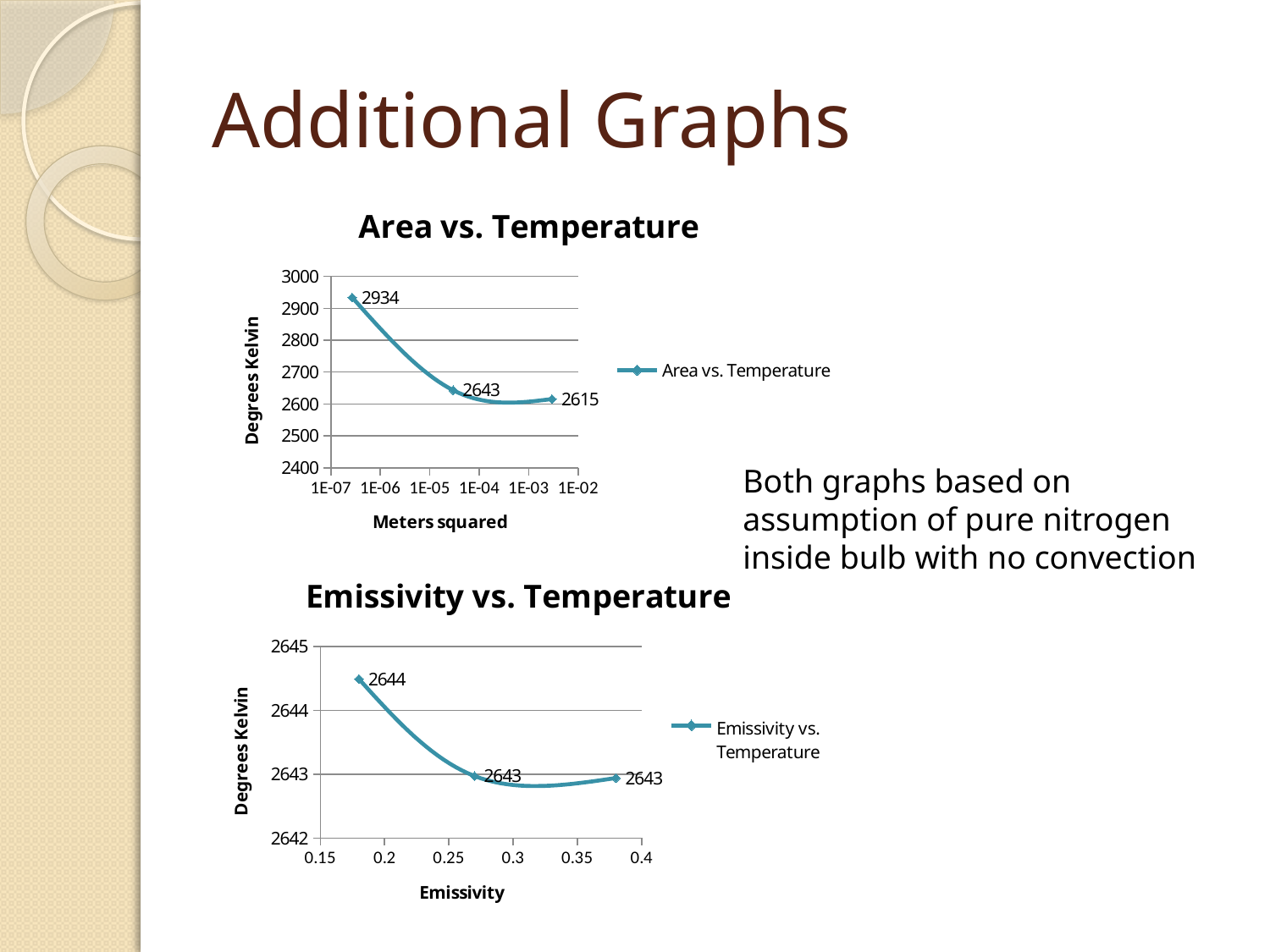
In the Emissivity vs. Temperature chart, what is the value of the last (rightmost) data point? 2643 In the Emissivity vs. Temperature chart, how many data points are plotted? 3 In the Emissivity vs. Temperature chart, is the first data point's value greater or less than the middle data point's value? greater In the Emissivity vs. Temperature chart, how many series does the legend list? 1 In the Emissivity vs. Temperature chart, what is the highest plotted temperature value? 2644 In the Area vs. Temperature chart, how many data points are plotted? 3 In the Area vs. Temperature chart, what is the highest plotted temperature value? 2934 In the Area vs. Temperature chart, what is the difference between the highest and lowest labelled values? 319 In the Area vs. Temperature chart, do the temperature values rise or fall as area increases along the x axis? fall In the Area vs. Temperature chart, what is the label on the x axis? Meters squared In the Area vs. Temperature chart, what is the lowest plotted temperature value? 2615 What kind of chart is the Emissivity vs. Temperature chart? line chart